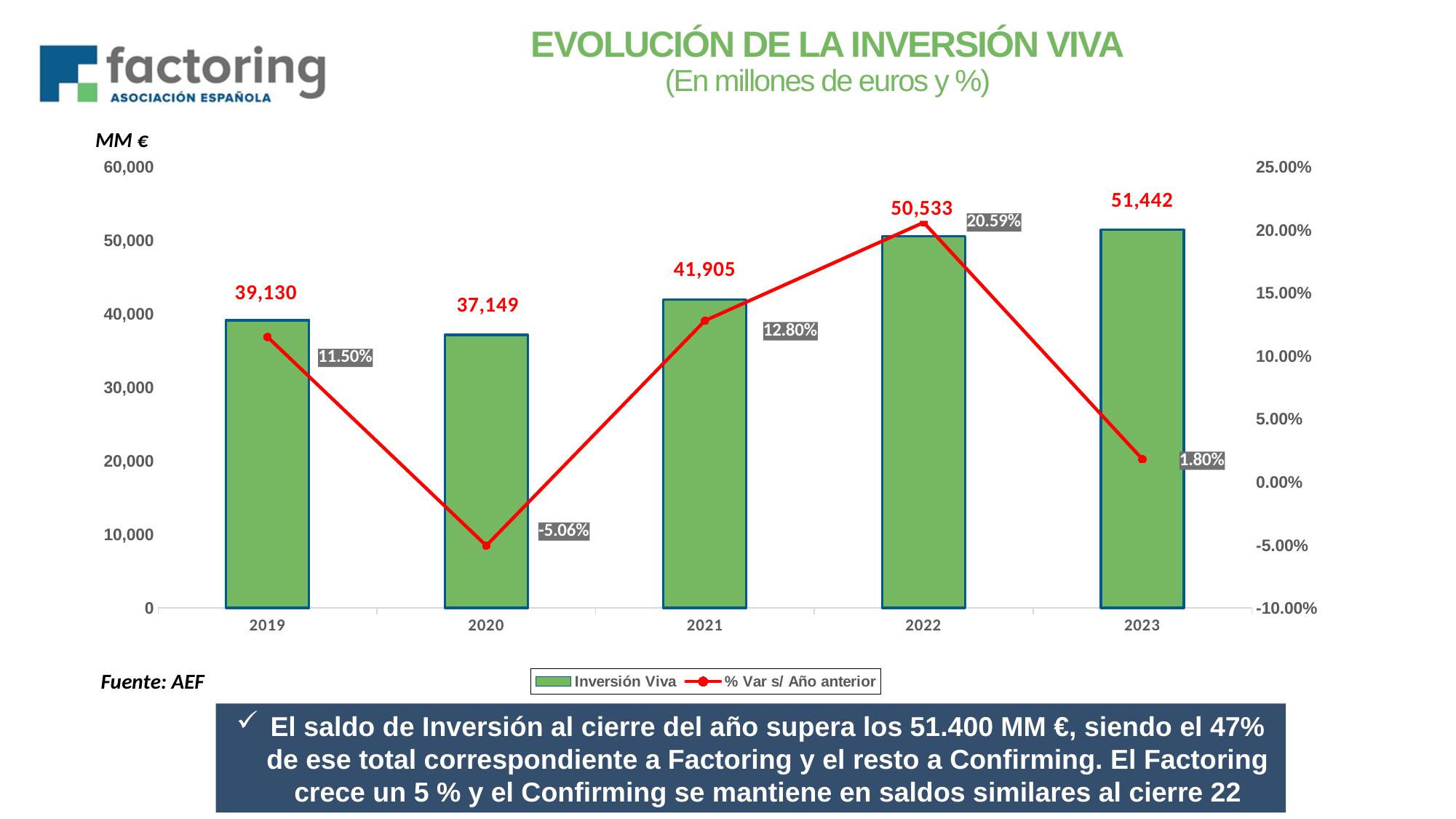
What is the title of the chart? EVOLUCIÓN DE LA INVERSIÓN VIVA What is the difference between the Inversión Viva values for 2022 and 2023? 909 Which is larger, the Inversión Viva value for 2019 or for 2020? 2019 Does the Inversión Viva value rise or fall from 2020 to 2022? rise What kind of chart is used for the Inversión Viva series? bar chart What is the Inversión Viva value for 2023? 51,442 Which year has the highest Inversión Viva value? 2023 What is the Inversión Viva value for 2021? 41,905 Which year has the lowest % Var s/ Año anterior value? 2020 How many years are shown on the x axis? 5 What is the % Var s/ Año anterior value for 2020? -5.06% How many series does the legend list? 2